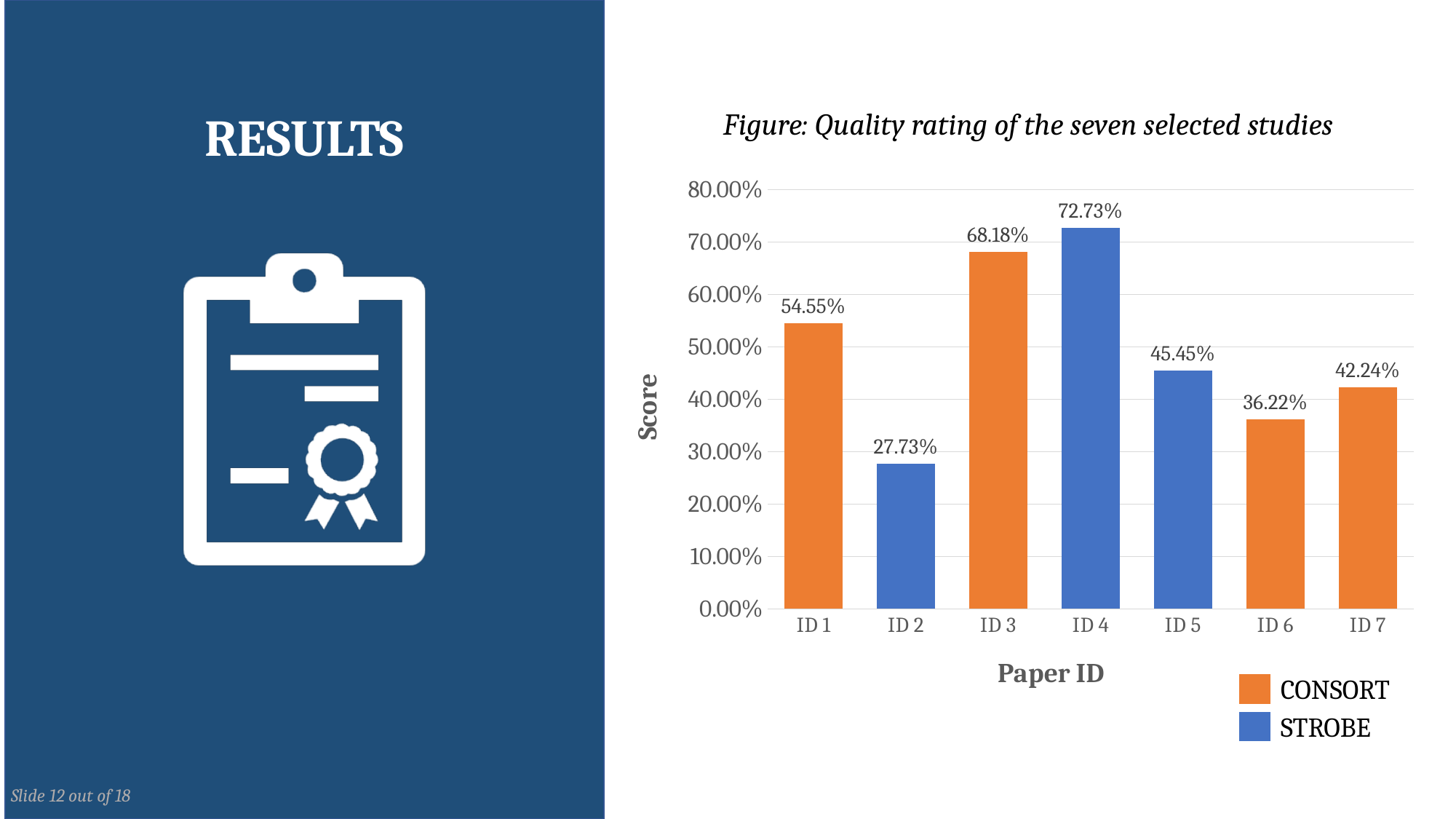
Which has a higher score, ID 5 or ID 7? ID 5 Which paper ID has the highest score? ID 4 What is the score for ID 4? 72.73% What kind of chart is shown on the slide? Bar chart Which paper ID has the lowest score? ID 2 What is the score for ID 2? 27.73% How many series does the legend list? 2 Which legend entry is shown in blue? STROBE How many paper IDs are shown on the x axis? 7 What is the difference between the scores for ID 3 and ID 1? 13.63% Is the score for ID 1 greater or less than 50.00%? greater What is the score for ID 6? 36.22%